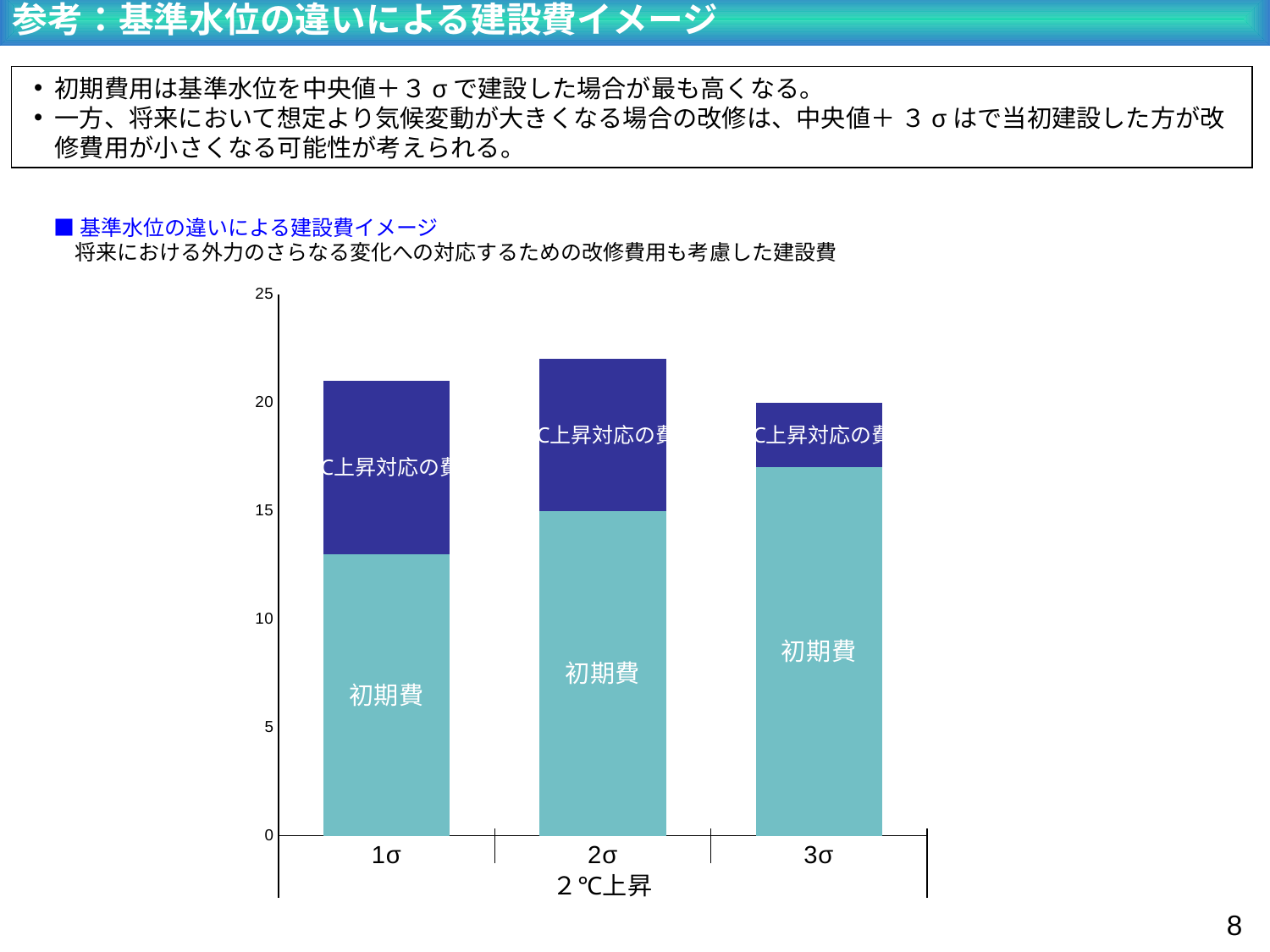
What label appears below the category axis of the chart? ２℃上昇 How many categories are shown on the x axis of the chart? 3 Which category has the lowest 初期費 value? 1σ Is the total height of the 2σ bar greater or less than 20? greater Which category has the highest 初期費 value? 3σ Is the 初期費 value for 1σ greater or less than 15? less Which is larger, the 初期費 value for 3σ or for 1σ? 3σ Is the 初期費 value for 3σ greater or less than 15? greater How many series are stacked in each bar of the chart? 2 Does the 初期費 value rise or fall from 1σ to 3σ? rise Which category has the smallest ℃上昇対応の費 segment? 3σ What kind of chart is shown on the slide? bar chart